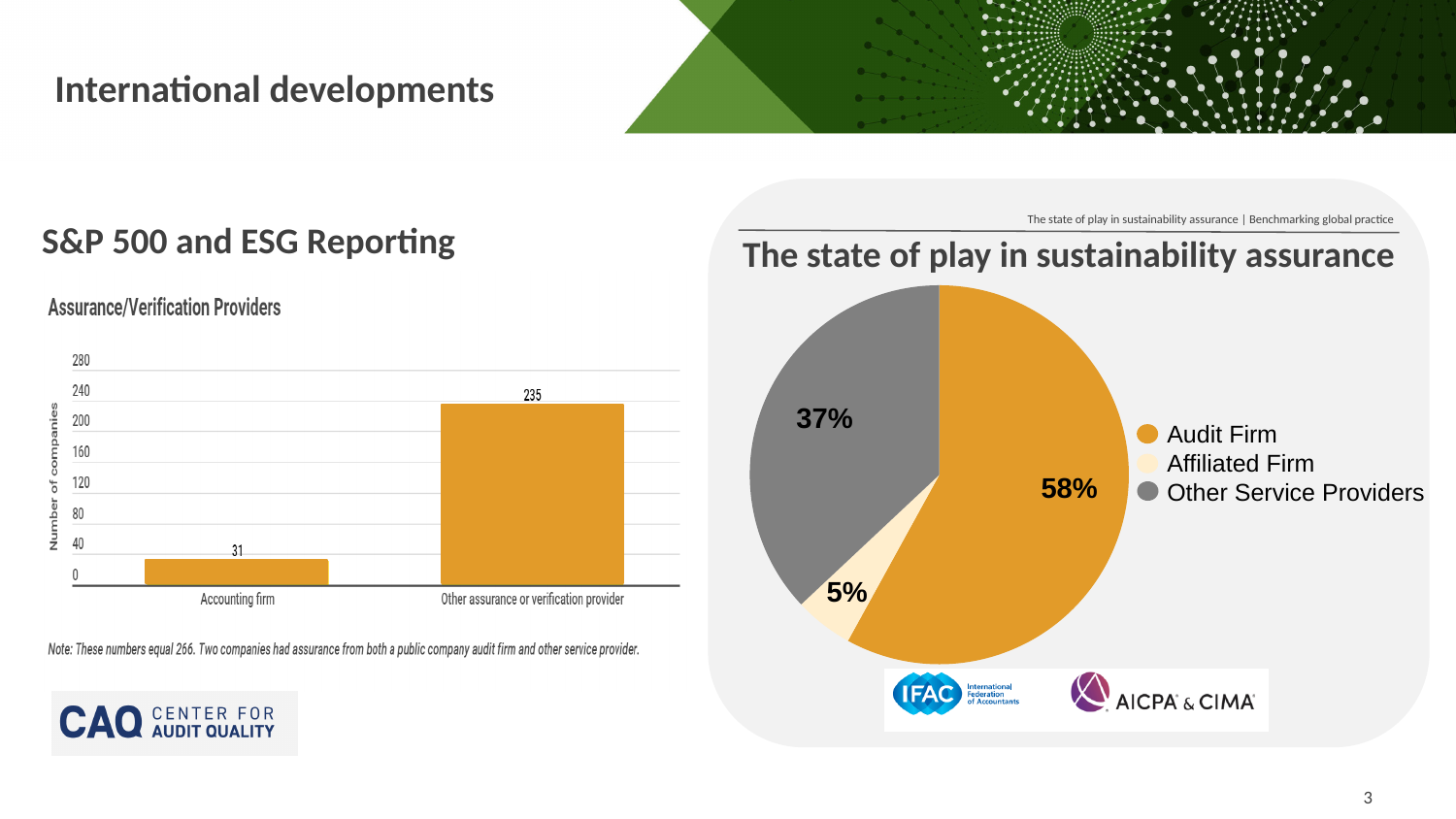
In the 'Assurance/Verification Providers' bar chart, what is the difference between Other assurance or verification provider and Accounting firm? 204 In the 'The state of play in sustainability assurance' pie chart, how many entries does the legend list? 3 In the 'The state of play in sustainability assurance' pie chart, what share does Other Service Providers have? 37% In the 'The state of play in sustainability assurance' pie chart, what share does Affiliated Firm have? 5% In the 'Assurance/Verification Providers' bar chart, what is the y-axis label? Number of companies In the 'Assurance/Verification Providers' bar chart, what is the value for Other assurance or verification provider? 235 In the 'Assurance/Verification Providers' bar chart, how many categories are shown? 2 What kind of chart is the 'Assurance/Verification Providers' chart? Bar chart In the 'Assurance/Verification Providers' bar chart, what is the value for Accounting firm? 31 In the 'The state of play in sustainability assurance' pie chart, which slice is the smallest? Affiliated Firm In the 'Assurance/Verification Providers' bar chart, which category has the highest value? Other assurance or verification provider In the 'The state of play in sustainability assurance' pie chart, what share does Audit Firm have? 58%